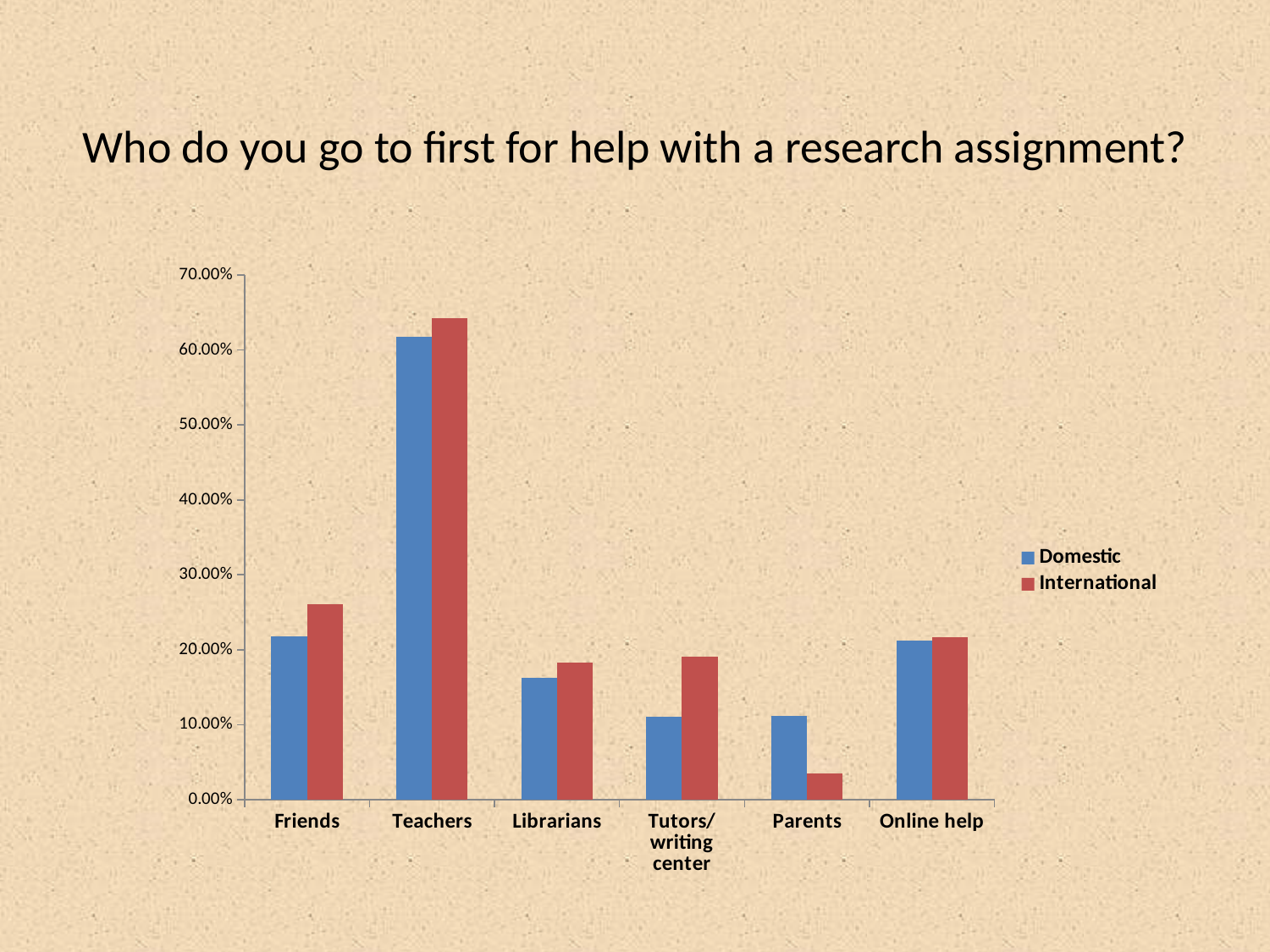
How many categories are shown on the x axis of the chart? 6 Which category has the highest International value? Teachers Is the International value for Parents greater or less than 10.00%? less Which category has the highest Domestic value? Teachers Which category has the lowest International value? Parents For Parents, which series has the larger value, Domestic or International? Domestic How many series does the legend list? 2 Is the Domestic value for Teachers greater or less than 50.00%? greater What colour represents the International series in the chart? red What kind of chart is shown on the slide? bar chart For Friends, which series has the larger value, Domestic or International? International For Tutors/writing center, which series has the larger value, Domestic or International? International